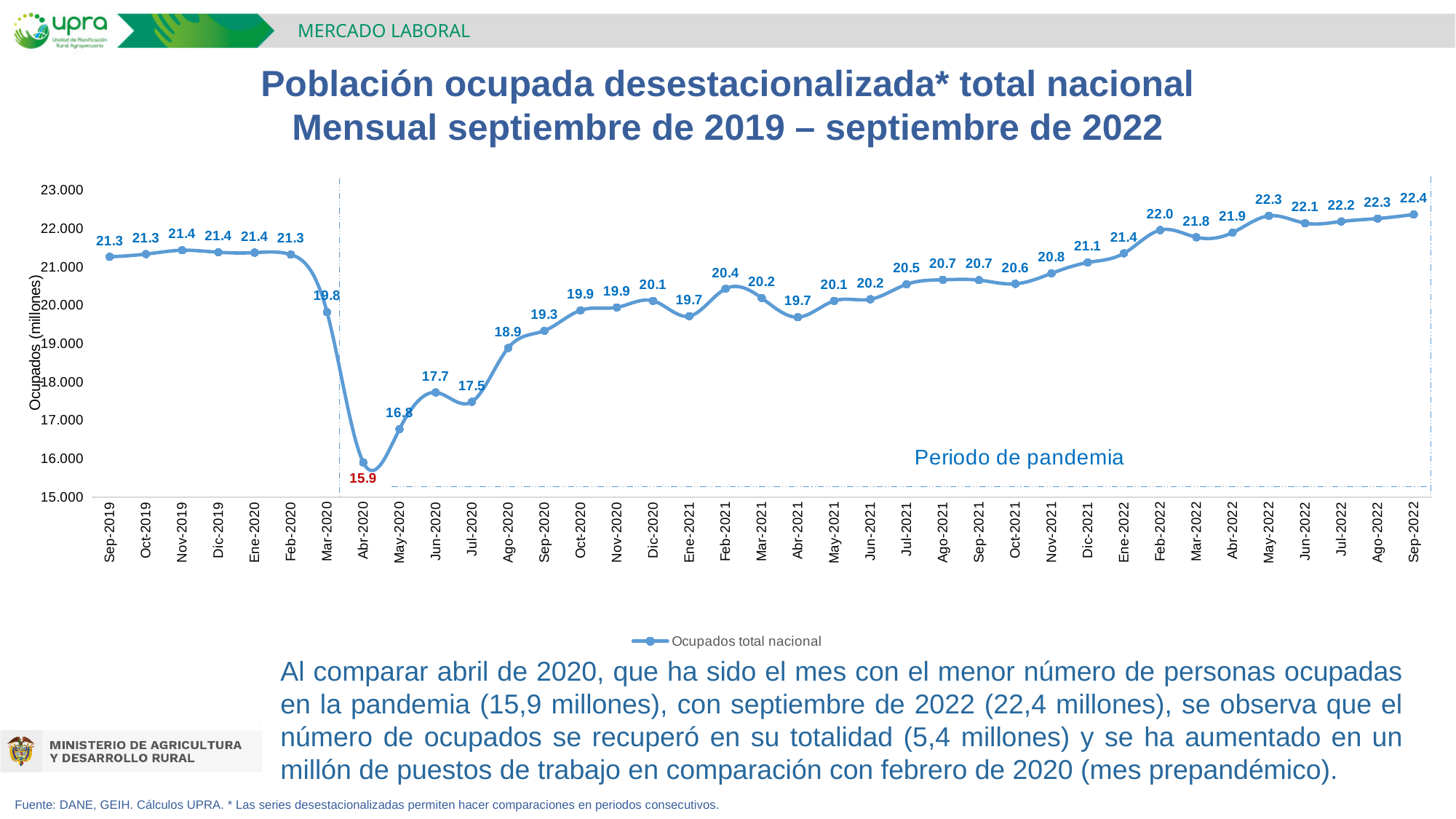
How many series does the legend list? 1 What is the value for Feb-2020? 21.3 What is the value for Abr-2020? 15.9 Do the values rise or fall from Abr-2020 to Ago-2020? rise What is the name of the series shown in the legend? Ocupados total nacional Which month has the lowest value? Abr-2020 What is the difference between the values for Sep-2022 and Abr-2020? 6.5 Which month has the highest value? Sep-2022 Which is larger, the value for Mar-2020 or the value for May-2020? Mar-2020 What is the value for Sep-2022? 22.4 Is the value for Jul-2020 greater or less than 18.000? less What type of chart is shown on the slide? Line chart